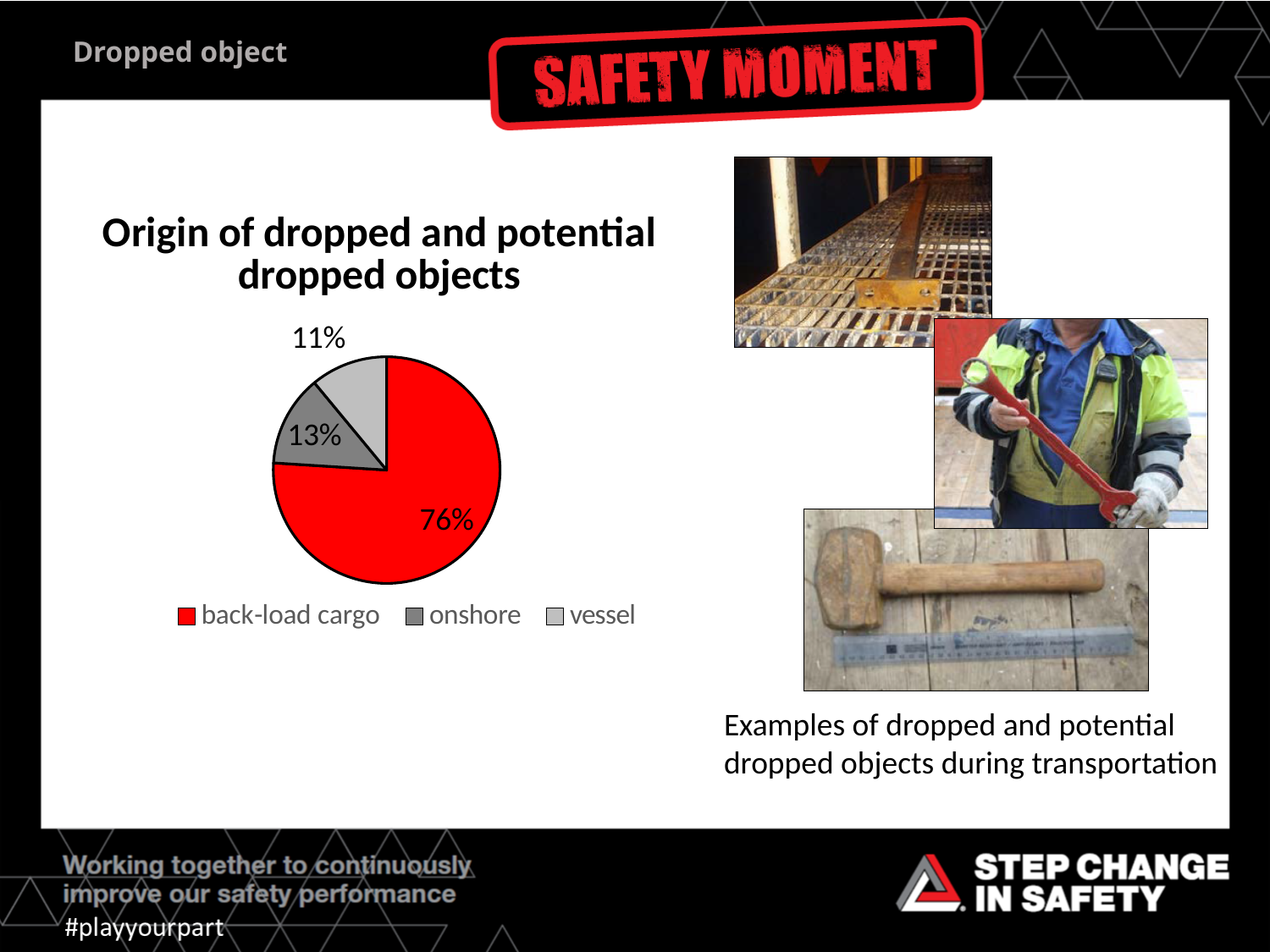
What is the difference between the onshore share and the vessel share? 2% What kind of chart is shown on the slide? pie chart What is the title of the chart? Origin of dropped and potential dropped objects What share of the pie is vessel? 11% What colour is the back-load cargo slice? red Which category has the largest slice of the pie? back-load cargo Which is larger, the onshore share or the vessel share? onshore How many categories does the pie chart show? 3 Which category has the smallest slice of the pie? vessel What share of the pie is onshore? 13% What share of the pie is back-load cargo? 76% What is the difference between the back-load cargo share and the onshore share? 63%